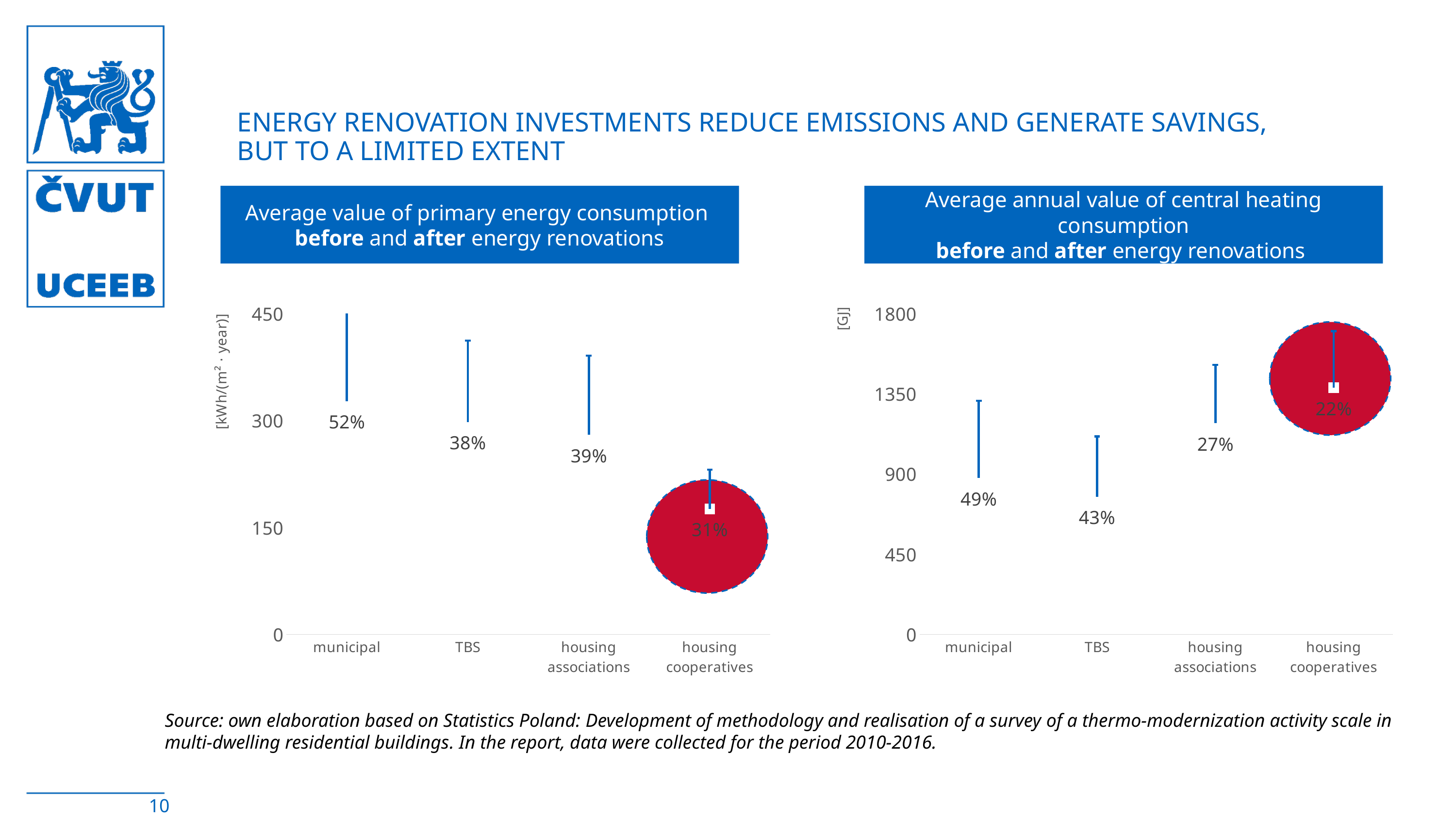
In the left chart (primary energy consumption), which category has the highest percentage label? municipal In the left chart (primary energy consumption), is the top (before) value for housing cooperatives greater or less than 300? less How many categories are shown on the x axis of the right chart (central heating consumption)? 4 In the left chart (primary energy consumption), what is the difference between the percentage labels for municipal and TBS? 14 percentage points In the right chart (central heating consumption), which has the larger percentage label, municipal or housing associations? municipal In the left chart (primary energy consumption), what percentage is labelled for housing cooperatives? 31% In the right chart (central heating consumption), what percentage is labelled for housing associations? 27% In the right chart (central heating consumption), what percentage is labelled for TBS? 43% In the left chart (primary energy consumption), what percentage reduction is shown for municipal buildings? 52% What unit is shown on the y axis of the right chart (central heating consumption)? [GJ] In the right chart (central heating consumption), which category has the lowest percentage label? housing cooperatives In the right chart (central heating consumption), is the top (before) value for housing cooperatives greater or less than 1350? greater